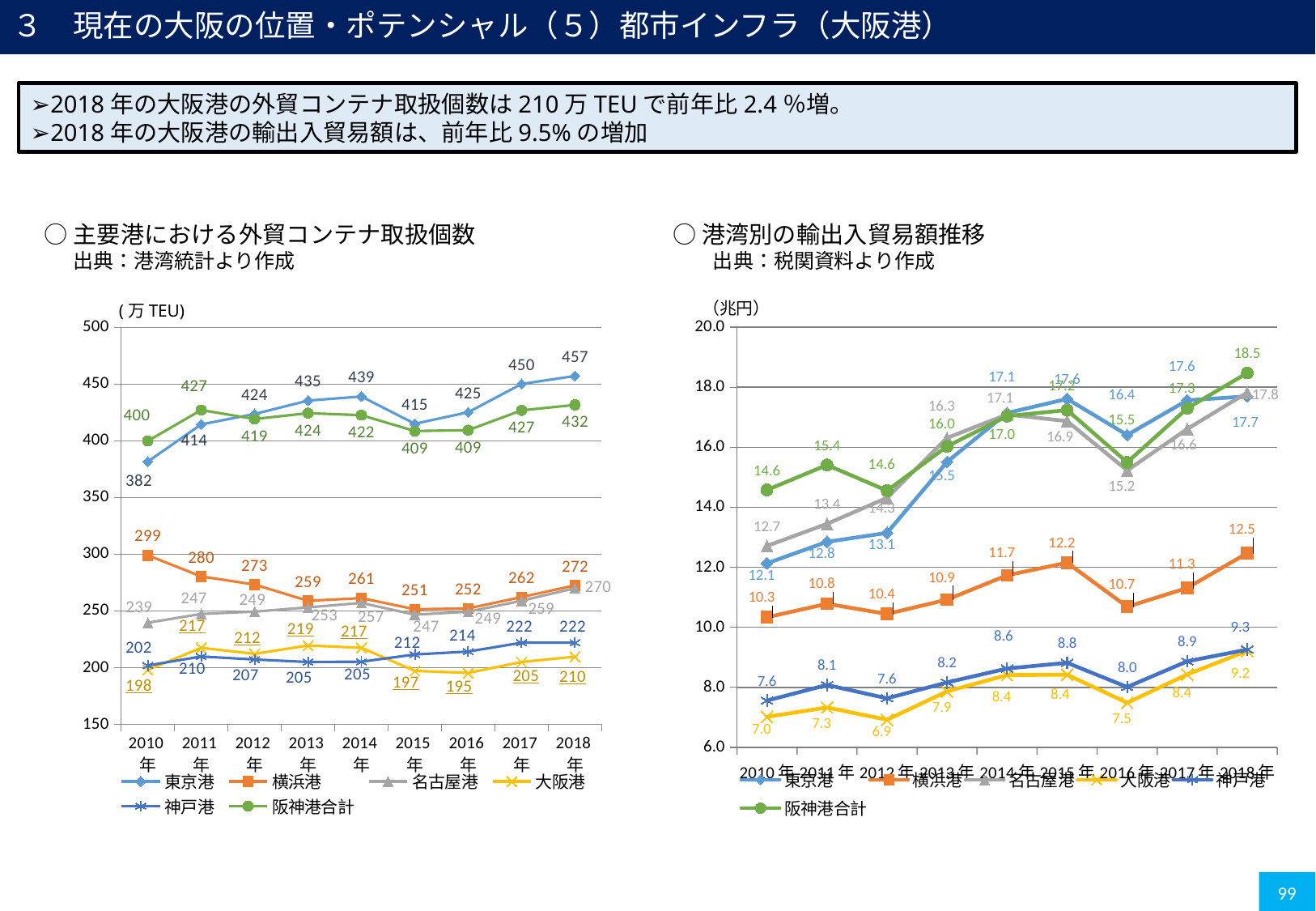
In the right chart (港湾別の輸出入貿易額推移), what is the difference between 神戸港 and 大阪港 in 2010年? 0.6 How many years are plotted on the x axis of the right chart (港湾別の輸出入貿易額推移)? 9 How many series does the legend of the left chart (主要港における外貿コンテナ取扱個数) list? 6 In the right chart (港湾別の輸出入貿易額推移), which year has the lowest value for 大阪港? 2012年 In the left chart (主要港における外貿コンテナ取扱個数), which year has the highest value for 横浜港? 2010年 In the left chart (主要港における外貿コンテナ取扱個数), what is the value for 大阪港 in 2018年? 210 In the left chart (主要港における外貿コンテナ取扱個数), what is the value for 東京港 in 2010年? 382 In the right chart (港湾別の輸出入貿易額推移), what is the value for 阪神港合計 in 2018年? 18.5 What kind of chart is the right chart (港湾別の輸出入貿易額推移)? line chart In the right chart (港湾別の輸出入貿易額推移), what is the value for 横浜港 in 2016年? 10.7 In the left chart (主要港における外貿コンテナ取扱個数), which is larger in 2015年, 神戸港 or 大阪港? 神戸港 In the left chart (主要港における外貿コンテナ取扱個数), what is the difference between 東京港 and 阪神港合計 in 2018年? 25